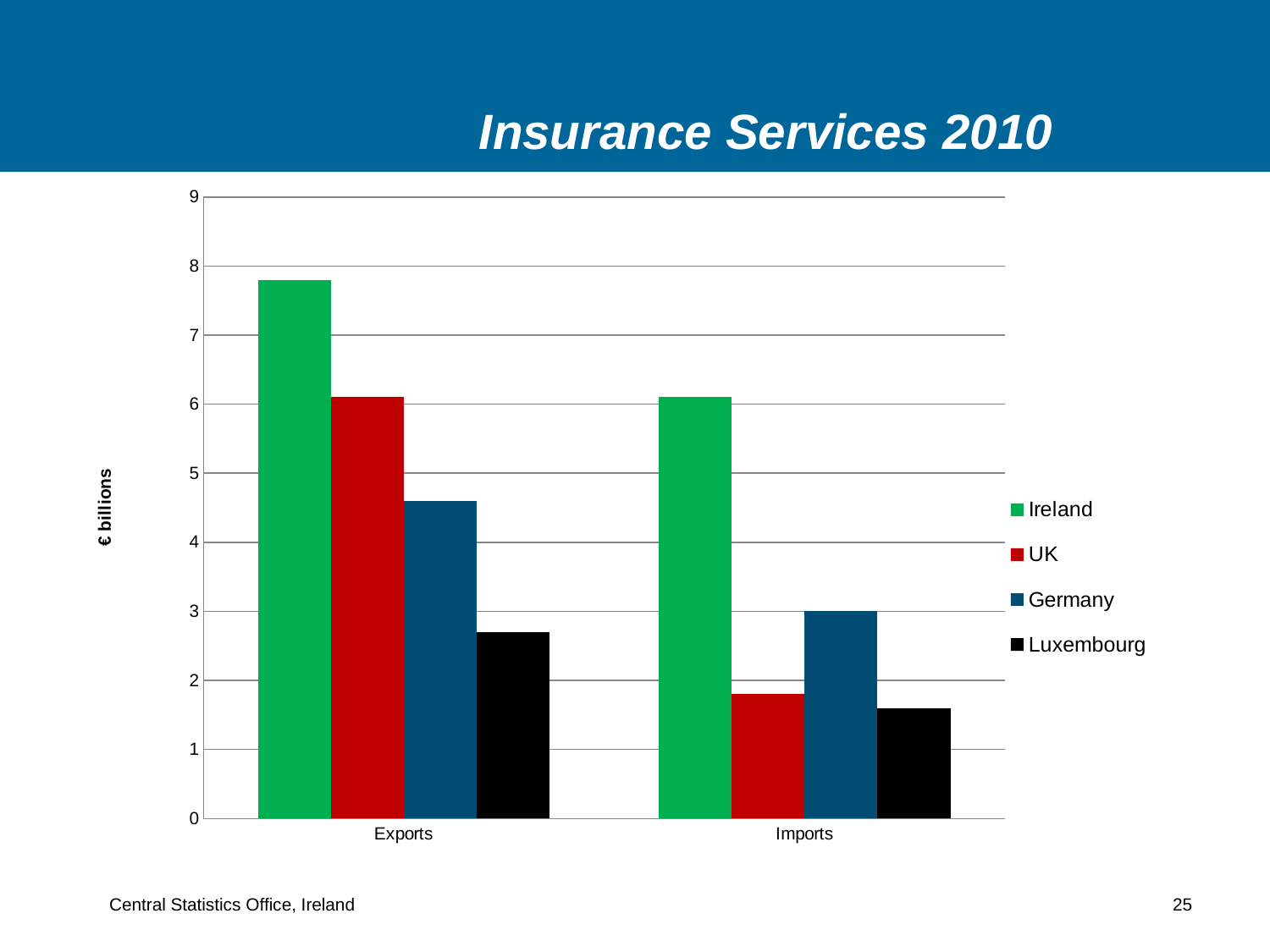
Which country has the highest value for Imports? Ireland Is the value for Ireland Exports greater or less than 7? greater Is the value for Germany Exports greater or less than 4? greater How many categories are shown on the x axis? 2 What is the title of the chart? Insurance Services 2010 What is the label on the vertical axis? € billions Which country has the lowest value for Exports? Luxembourg What type of chart is shown on the slide? bar chart Which is larger: the UK value for Exports or the UK value for Imports? Exports Is the value for UK Imports greater or less than 2? less How many series does the legend list? 4 Which country has the highest value for Exports? Ireland